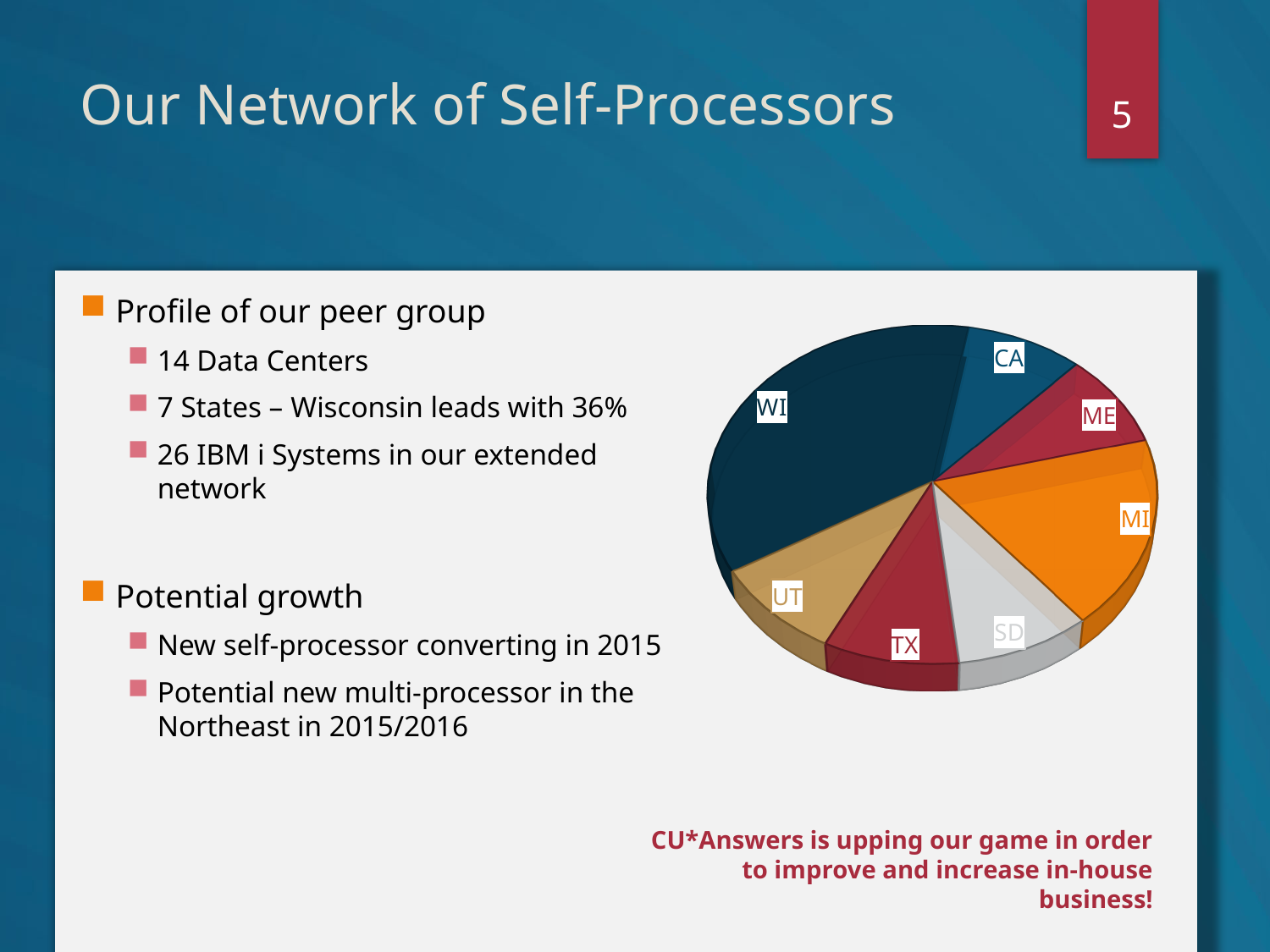
What colour is the WI slice in the pie chart? dark blue How many slices does the pie chart have? 7 Which slice is larger in the pie chart, MI or CA? MI Which state has the largest slice in the pie chart? WI Which slice is larger in the pie chart, WI or MI? WI What kind of chart is shown on the slide? pie chart What colour is the MI slice in the pie chart? orange Which slice is larger in the pie chart, WI or UT? WI